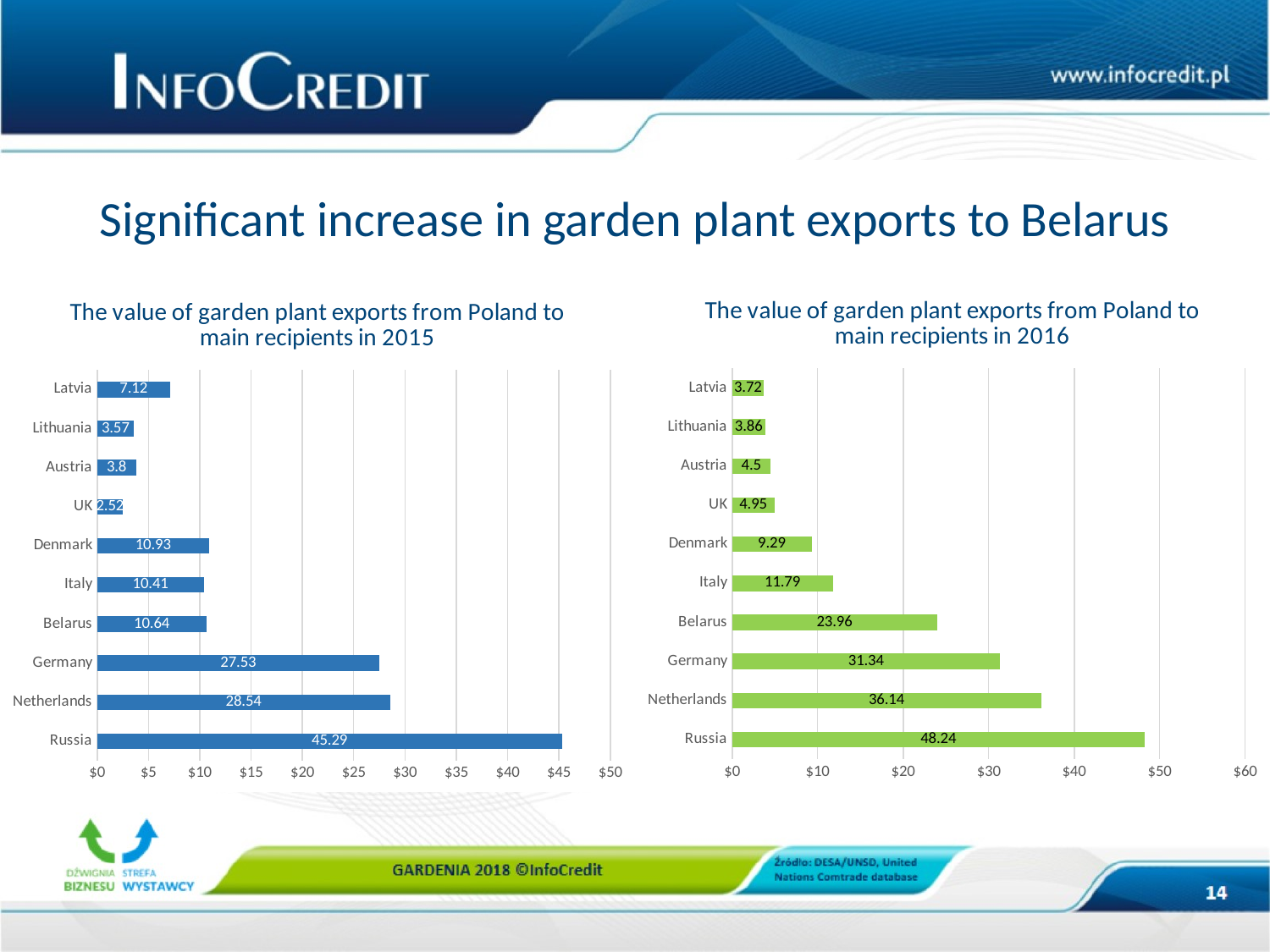
In the 2015 chart, which country has the lowest value? UK In the 2015 chart, which is larger, the value for Belarus or the value for Italy? Belarus In the 2015 chart, what is the value for Denmark? 10.93 In the 2016 chart, what is the difference between the values for Netherlands and Germany? 4.8 In the 2016 chart, is the value for Germany greater or less than $30? greater What kind of chart is the 2016 chart? bar chart In the 2016 chart, which country has the highest value? Russia In the 2016 chart, what is the difference between the values for Belarus and Denmark? 14.67 In the 2016 chart, what is the value for Belarus? 23.96 How many countries are shown in the 2015 chart? 10 In the 2015 chart, what is the value for Russia? 45.29 What is the title of the chart on the left? The value of garden plant exports from Poland to main recipients in 2015